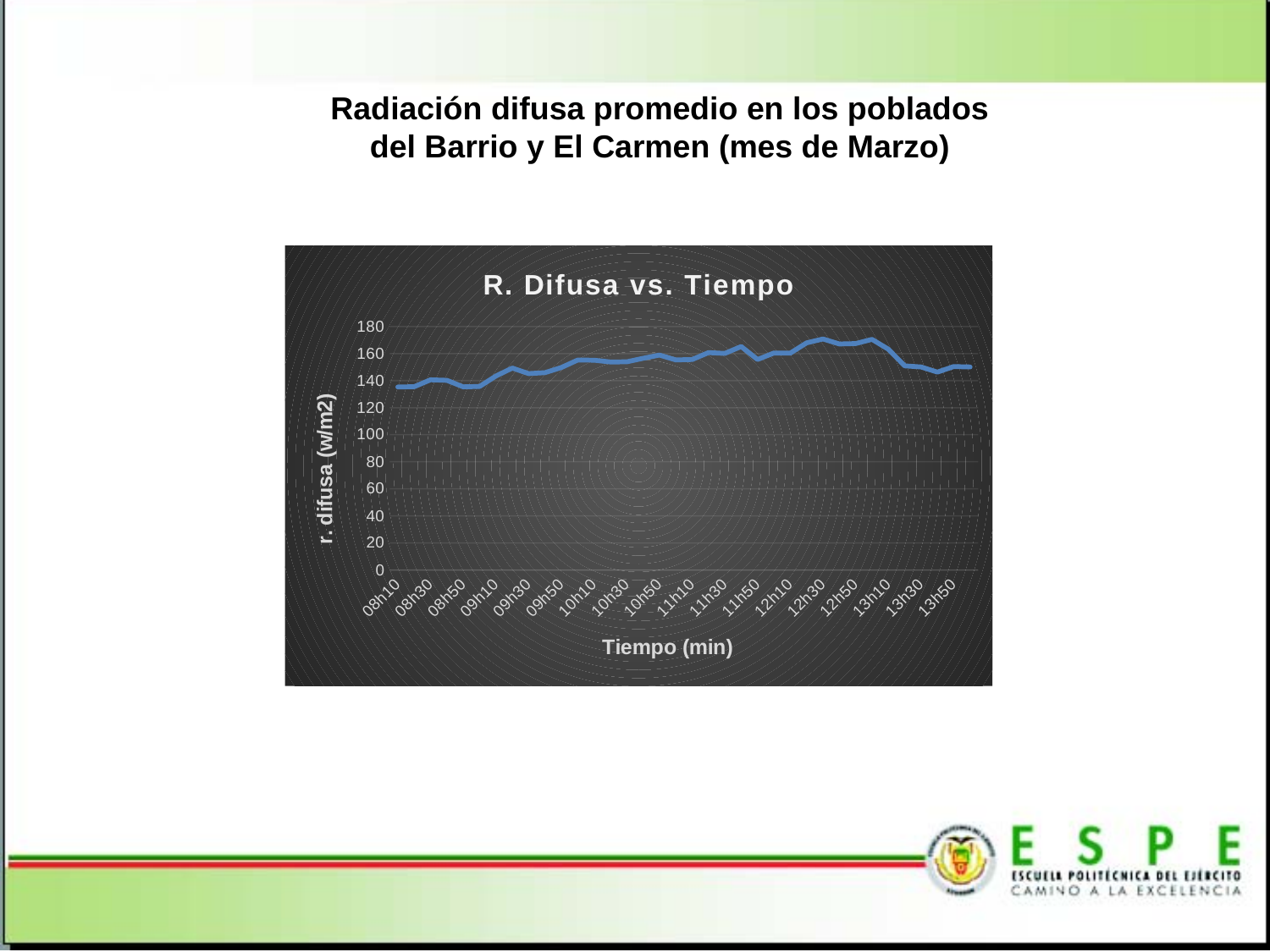
Which is larger, the value at 12h30 or the value at 08h10? 12h30 Is the value at 08h10 greater or less than 140? less What is the label of the vertical axis of the chart? r. difusa (w/m2) Does the line generally rise or fall between 08h10 and 12h30? rise Which is larger, the value at 08h50 or the value at 11h30? 11h30 What is the title of the chart? R. Difusa vs. Tiempo Is the value at 10h10 greater or less than 140? greater What kind of chart is shown on the slide? line chart Does the line rise or fall between 13h10 and 13h30? fall Is the value at 12h30 greater or less than 160? greater